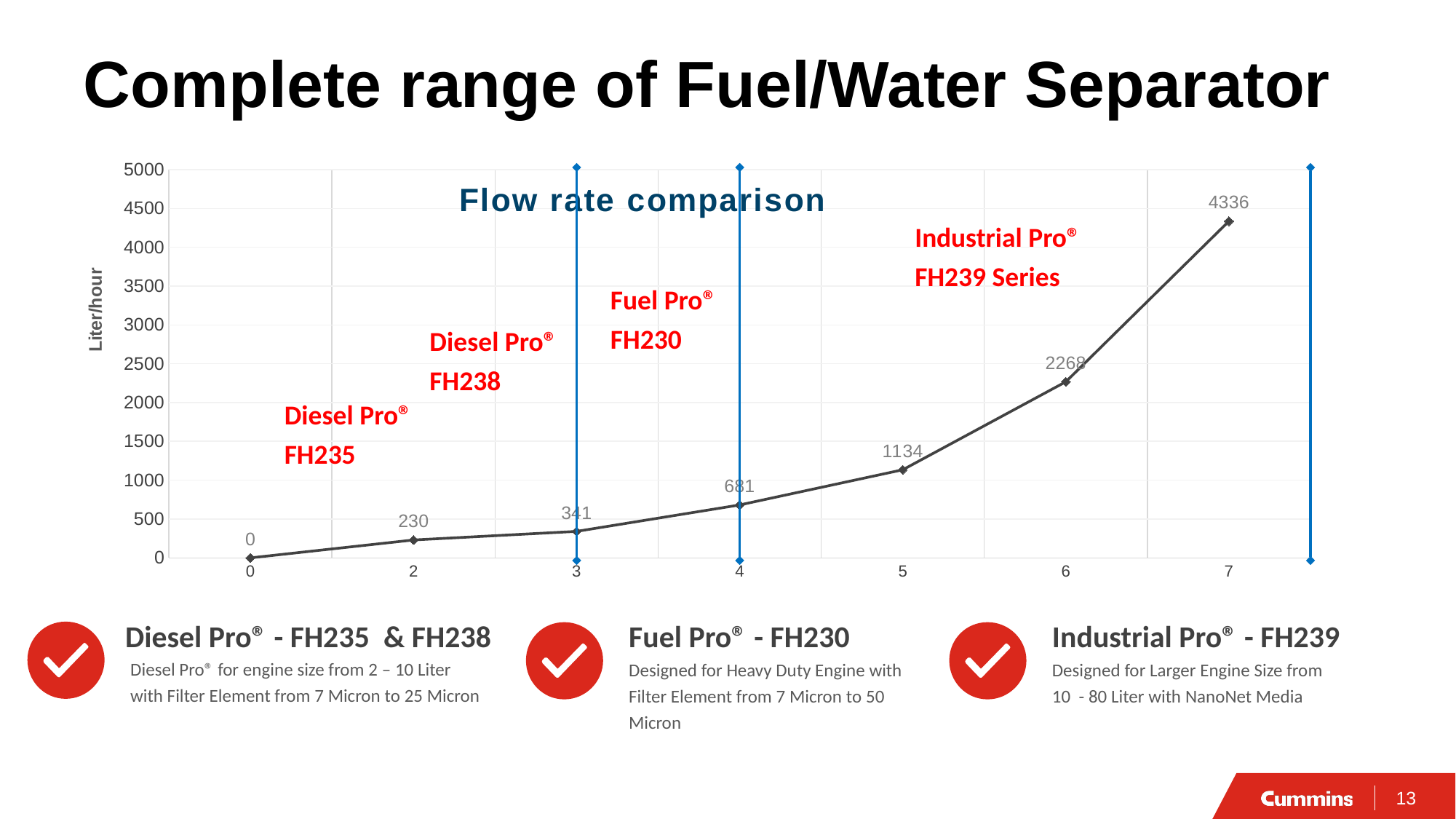
What is the title of the chart? Flow rate comparison What type of chart is shown on the slide? Line chart What is the y-axis label of the chart? Liter/hour What is the value at x = 7 on the chart? 4336 How many data points are plotted on the chart? 7 What is the value at x = 2 on the chart? 230 Which is larger, the value at x = 3 or the value at x = 4? x = 4 Which x value has the highest flow rate on the chart? 7 What is the value at x = 4 on the chart? 681 What is the value at x = 5 on the chart? 1134 What is the difference between the values at x = 6 and x = 5? 1134 Which x value has the lowest flow rate on the chart? 0